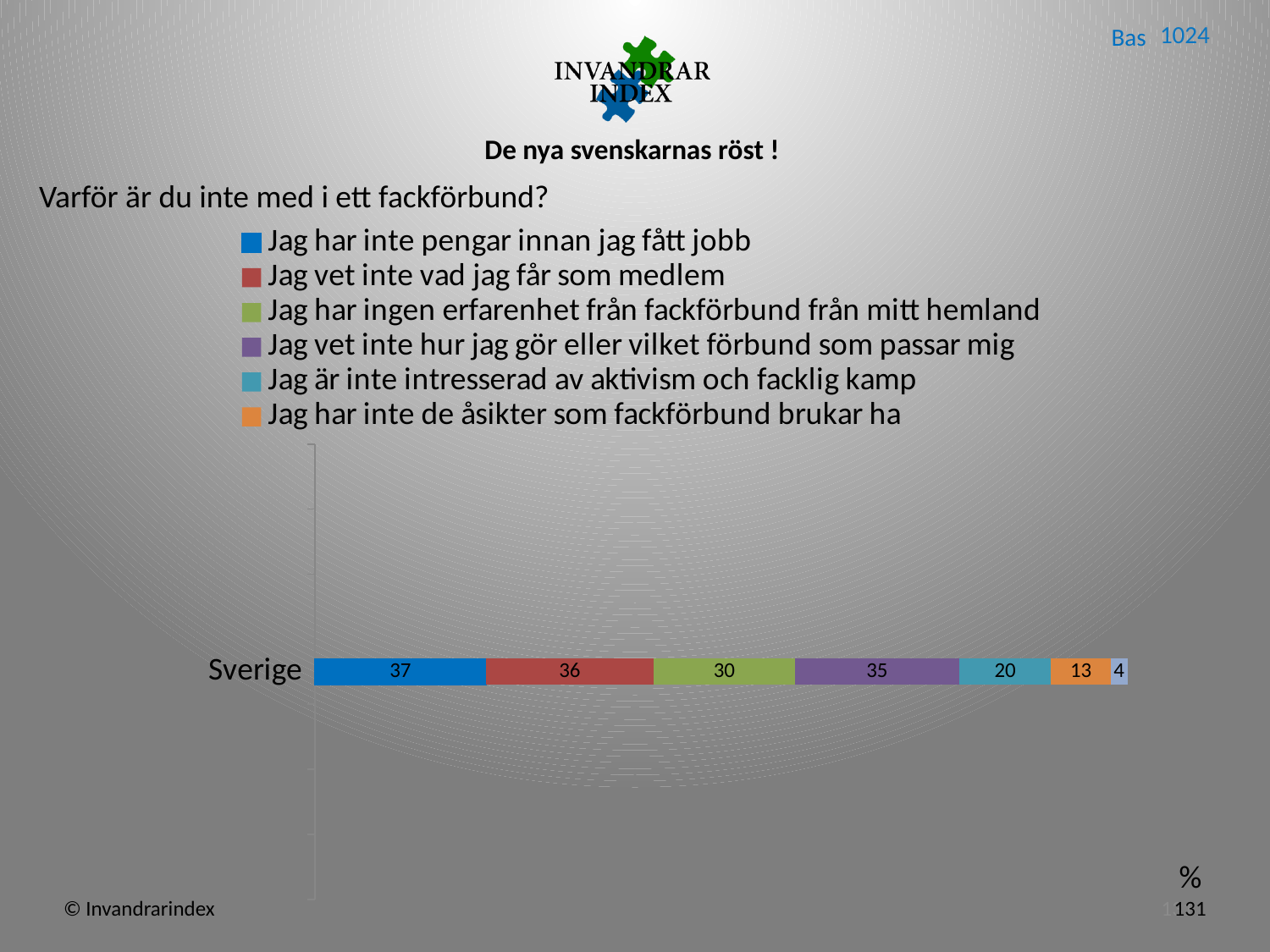
What kind of chart is shown on the slide? Stacked bar chart How many series does the legend list? 6 What value is shown for "Jag har inte pengar innan jag fått jobb" in the Sverige bar? 37 What value is shown for "Jag vet inte hur jag gör eller vilket förbund som passar mig"? 35 Which is larger: the value for "Jag har ingen erfarenhet från fackförbund från mitt hemland" or for "Jag vet inte hur jag gör eller vilket förbund som passar mig"? Jag vet inte hur jag gör eller vilket förbund som passar mig What value is shown for "Jag vet inte vad jag får som medlem" in the Sverige bar? 36 What value is shown for "Jag har ingen erfarenhet från fackförbund från mitt hemland"? 30 What is the difference between the values for "Jag har inte pengar innan jag fått jobb" and "Jag är inte intresserad av aktivism och facklig kamp"? 17 Which legend entry has the highest value in the Sverige bar? Jag har inte pengar innan jag fått jobb What value is shown for "Jag har inte de åsikter som fackförbund brukar ha"? 13 What value is shown for "Jag är inte intresserad av aktivism och facklig kamp"? 20 Which legend entry has the lowest value in the Sverige bar? Jag har inte de åsikter som fackförbund brukar ha